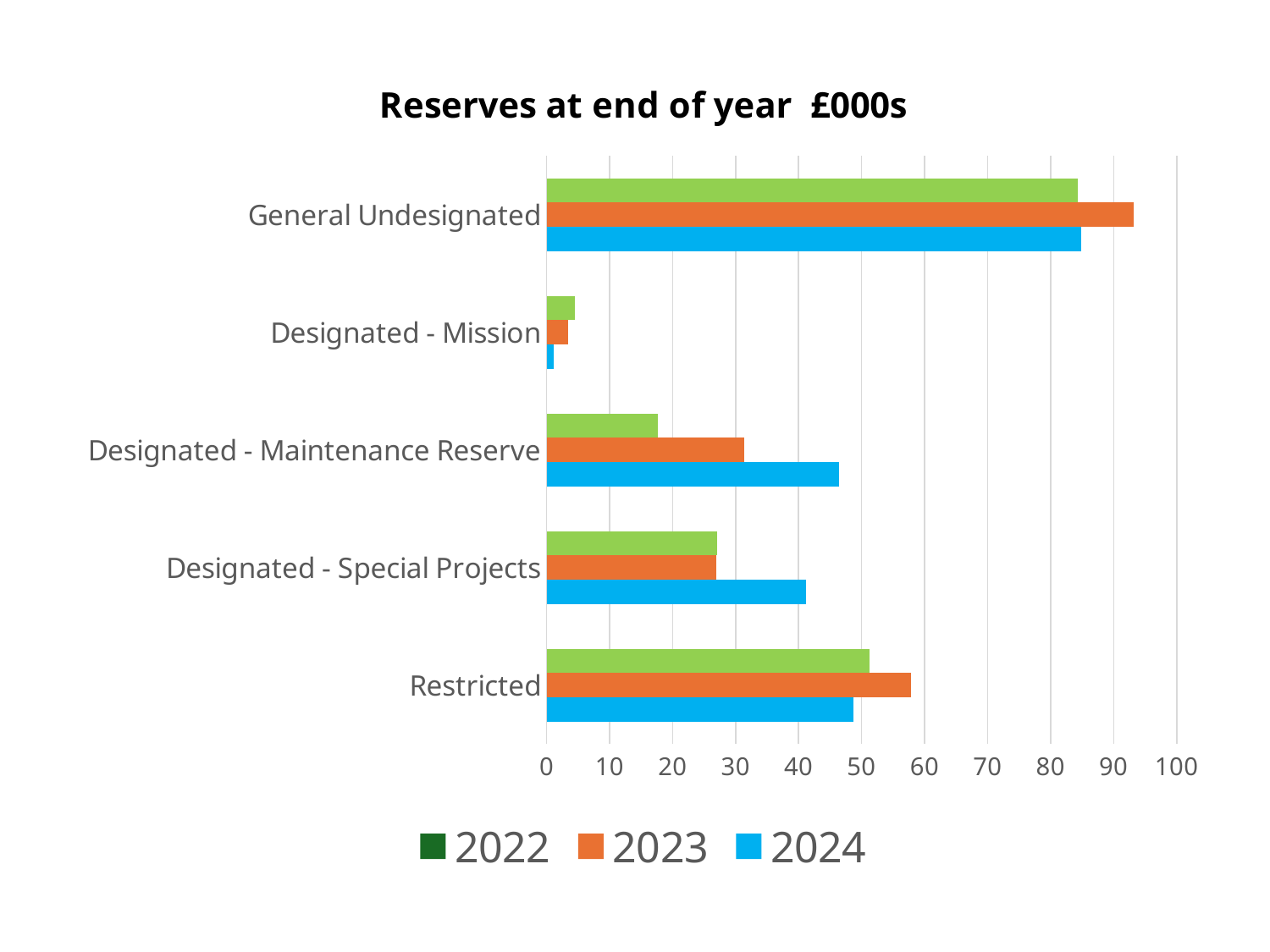
How many series does the legend list? 3 How many categories are shown on the chart? 5 What is the title of the chart? Reserves at end of year £000s What kind of chart is shown on the slide? bar chart For Designated - Maintenance Reserve, do the values rise or fall from 2022 to 2024? rise Is the value for Designated - Maintenance Reserve in 2022 greater or less than 20? less Which category has the lowest value for 2024? Designated - Mission Which years are listed in the legend? 2022, 2023, 2024 Is the value for General Undesignated in 2023 greater or less than 90? greater Which category has the highest value for 2023? General Undesignated For Designated - Maintenance Reserve, which year has the larger value, 2023 or 2024? 2024 Is the value for Designated - Special Projects in 2024 greater or less than 30? greater